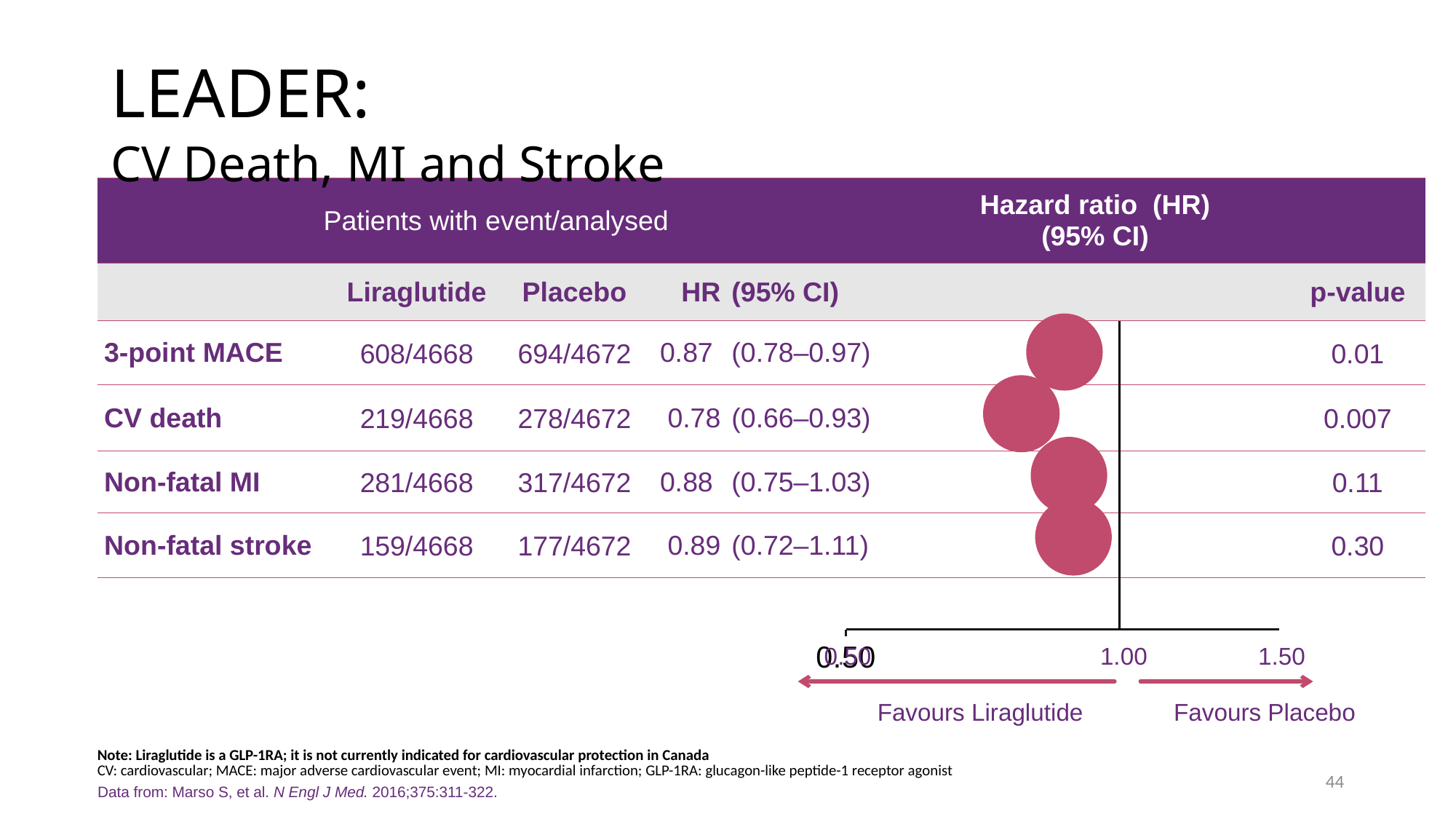
How many outcomes are plotted in the hazard ratio chart? 4 Which outcome has the lowest hazard ratio? CV death What kind of chart is used to display the hazard ratios? Bubble chart Which outcome has the highest hazard ratio? Non-fatal stroke What is the hazard ratio for non-fatal stroke? 0.89 What does the left side of the hazard ratio axis favour, according to the label? Favours Liraglutide What is the 95% CI for the 3-point MACE hazard ratio? 0.78–0.97 Which has the larger hazard ratio, 3-point MACE or non-fatal MI? Non-fatal MI Is the hazard ratio point for CV death greater or less than 1.00? less What is the difference between the hazard ratios for non-fatal stroke and CV death? 0.11 What is the p-value for non-fatal MI? 0.11 What is the hazard ratio for CV death? 0.78